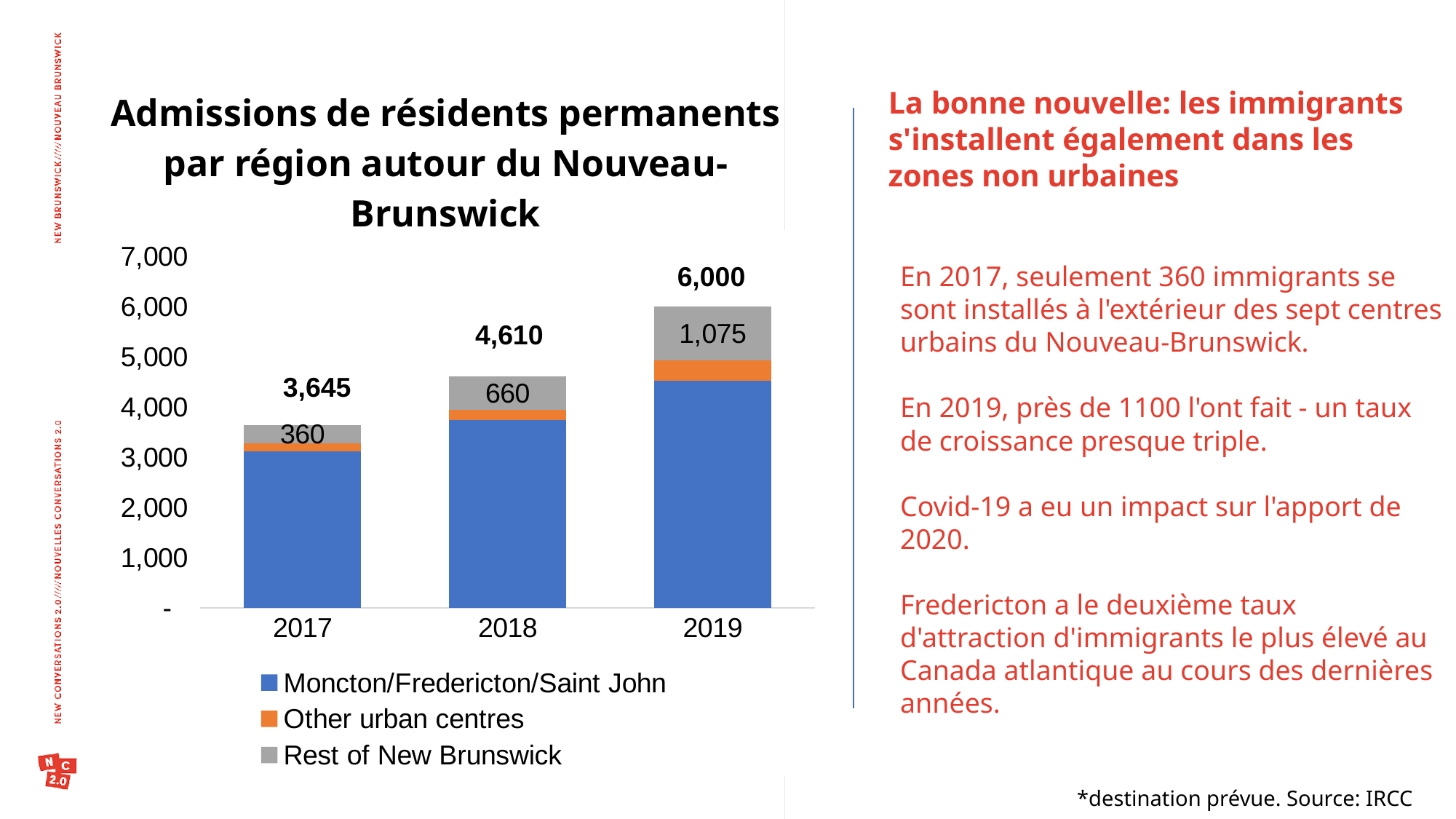
What is the difference between the total admissions in 2019 and in 2017? 2,355 Do the total admissions rise or fall from 2017 to 2019? rise By how much did the Rest of New Brunswick value increase from 2017 to 2019? 715 What is the value for Rest of New Brunswick in 2019? 1,075 How many series does the legend list? 3 Which year has the lowest value for Rest of New Brunswick? 2017 Which year has the highest total admissions? 2019 What is the total value labelled above the 2017 bar? 3,645 What is the total permanent resident admissions shown for 2019? 6,000 How many years are shown on the x axis? 3 Is the Moncton/Fredericton/Saint John value for 2019 greater or less than 4,000? greater What is the value for Rest of New Brunswick in 2018? 660